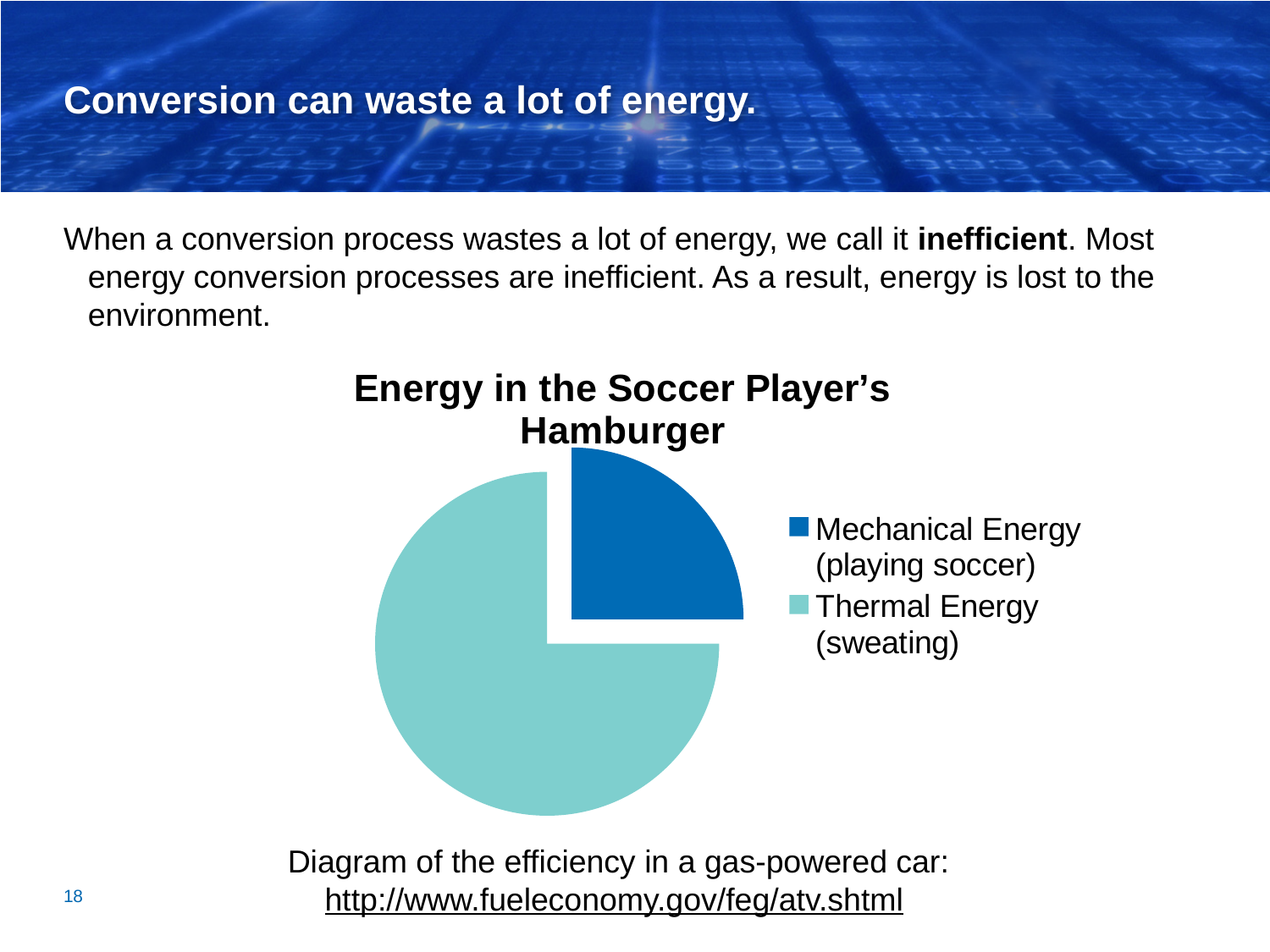
Which legend entry in the pie chart is shown in dark blue? Mechanical Energy (playing soccer) How many entries does the legend of the pie chart list? 2 What kind of chart is shown on the slide? Pie chart Which slice of the pie chart is the largest? Thermal Energy (sweating) What is the title of the pie chart? Energy in the Soccer Player's Hamburger Which slice of the pie chart is the smallest? Mechanical Energy (playing soccer) Which is larger in the pie chart: Mechanical Energy (playing soccer) or Thermal Energy (sweating)? Thermal Energy (sweating) How many slices does the pie chart have? 2